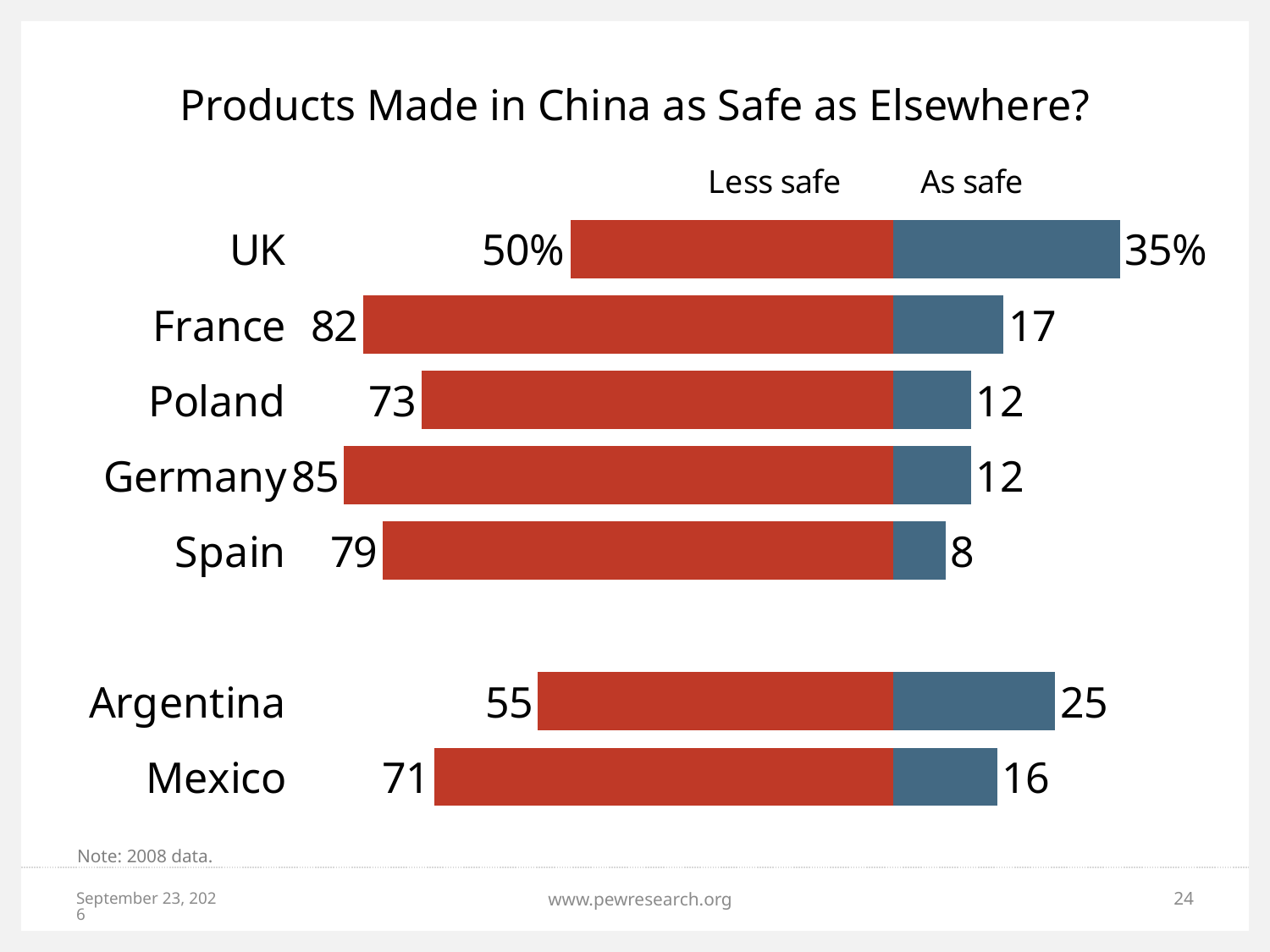
Which is larger, the 'As safe' value for Mexico or for Poland? Mexico Which country has the highest 'As safe' value? UK What is the 'As safe' value for France? 17 How many series does the chart show? 2 How many countries are shown in the chart? 7 Which country has the highest 'Less safe' value? Germany What is the difference between the 'Less safe' values for France and Mexico? 11 What is the 'Less safe' value for Germany? 85 What percentage of respondents in the UK say products made in China are less safe? 50% What type of chart is shown on the slide? Bar chart What is the 'As safe' value for Argentina? 25 Which country has the lowest 'As safe' value? Spain